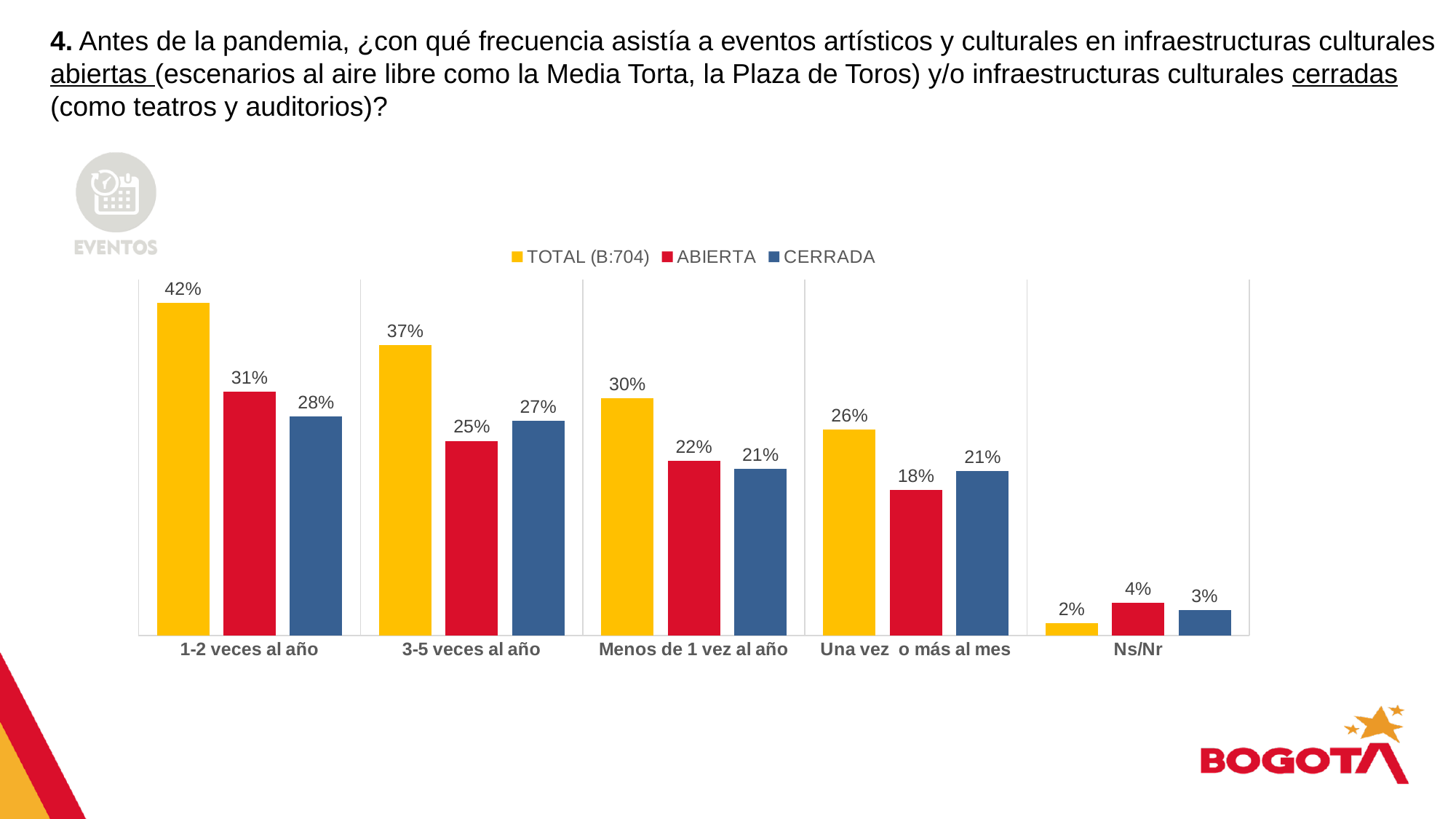
Which category has the highest TOTAL (B:704) value? 1-2 veces al año Which category has the lowest CERRADA value? Ns/Nr How many categories are shown on the x axis? 5 Which colour represents the ABIERTA series? Red What is the TOTAL (B:704) value for "1-2 veces al año"? 42% What is the ABIERTA value for "3-5 veces al año"? 25% How many series does the legend list? 3 For "3-5 veces al año", which is larger: the ABIERTA value or the CERRADA value? CERRADA What is the CERRADA value for "Una vez o más al mes"? 21% What kind of chart is shown on the slide? Bar chart What is the difference between the TOTAL (B:704) and ABIERTA values for "Menos de 1 vez al año"? 8% What is the ABIERTA value for "Ns/Nr"? 4%